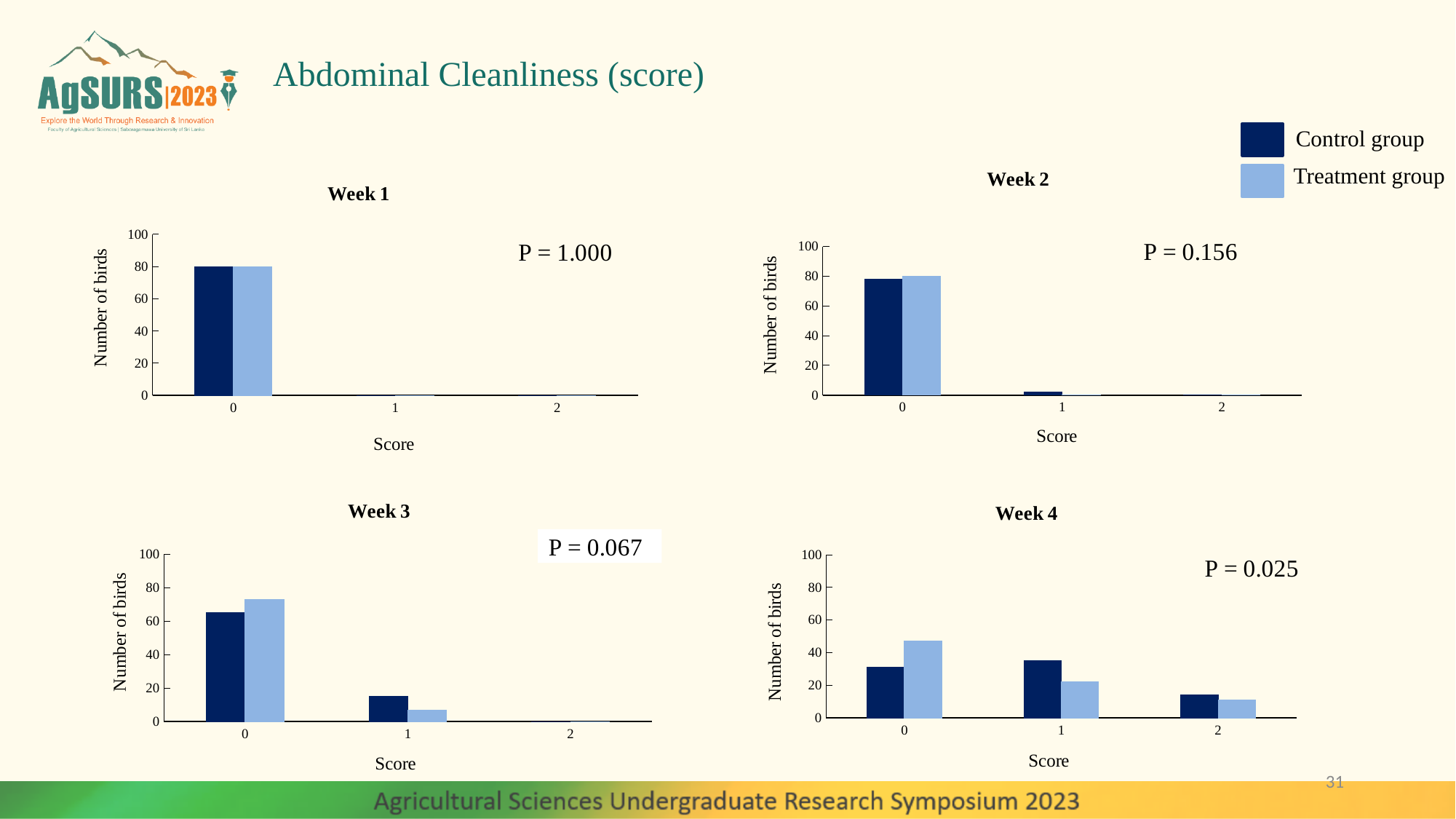
In the Week 4 chart, which score has the highest number of birds for the Treatment group? 0 In the Week 1 chart, what is the number of birds for the Control group at score 0? 80 How many series does the legend list for the charts? 2 In the Week 4 chart, at score 1, which group has the larger number of birds? Control group In the Week 3 chart, at score 0, which group has the larger number of birds? Treatment group In the Week 4 chart, is the value for the Control group at score 0 greater or less than 40? less In the Week 3 chart, is the value for the Treatment group at score 0 greater or less than 60? greater What kind of chart is the Week 1 chart? bar chart What P value is shown on the Week 4 chart? P = 0.025 In the Week 4 chart, which score has the lowest number of birds for the Treatment group? 2 In the Week 4 chart, how many score categories are shown on the x axis? 3 In the Week 3 chart, is the value for the Control group at score 1 greater or less than 20? less